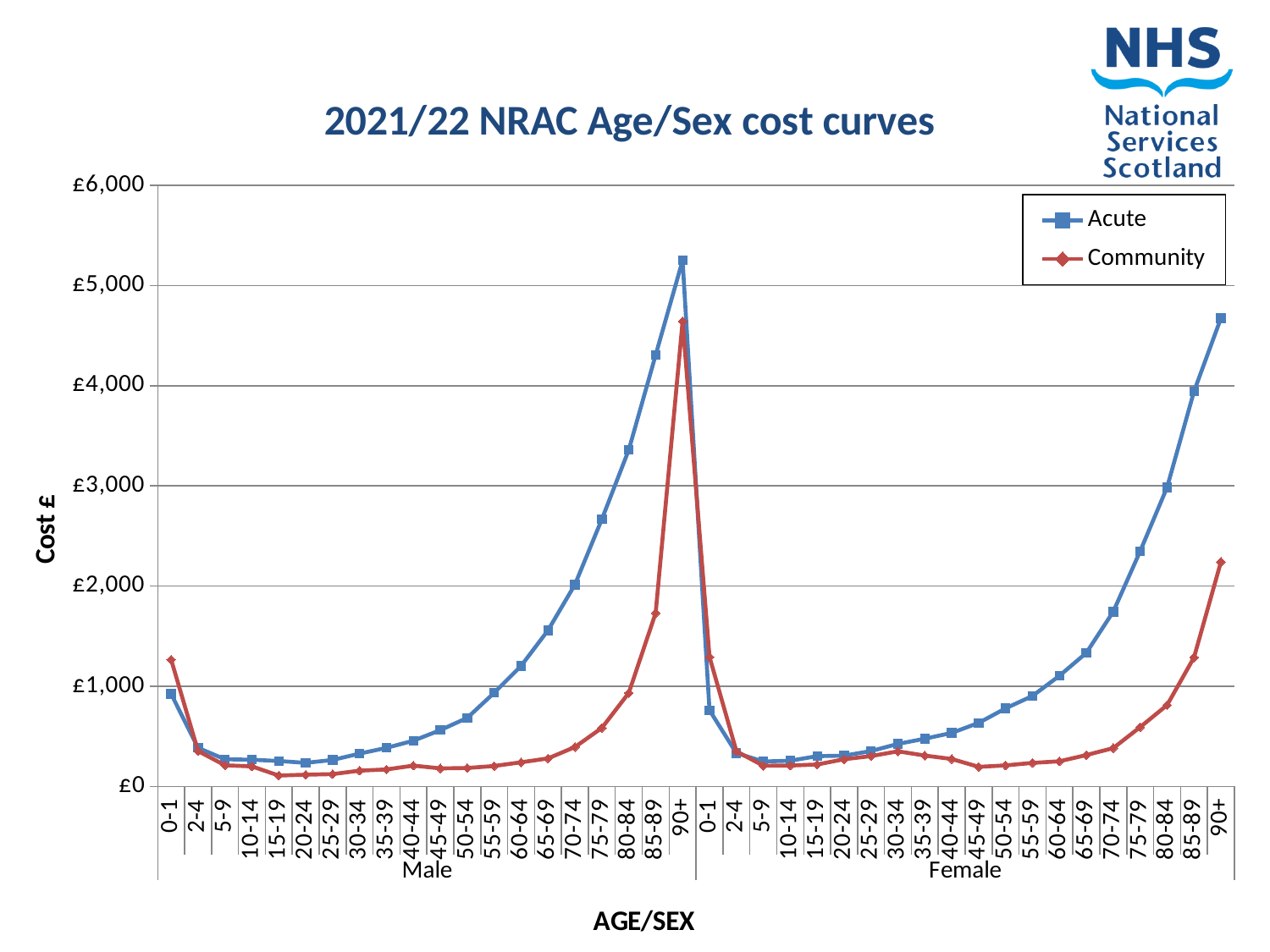
At which age/sex category is the Community series at its lowest? Male 15-19 How many age groups are plotted for each sex on the x axis? 20 Is the Community value for Female 90+ greater or less than £2,000? greater For Male 0-1, which series has the higher value, Acute or Community? Community Which two series are listed in the legend? Acute and Community At which age/sex category does the Acute series reach its highest value? Male 90+ Does the Acute series rise or fall from Male 25-29 to Male 90+? Rise What kind of chart is shown on the slide? Line chart At which age/sex category does the Community series reach its highest value? Male 90+ Is the Acute value for Male 90+ greater or less than £5,000? greater Is the Community value for Male 85-89 greater or less than £2,000? less How many series does the legend list? 2